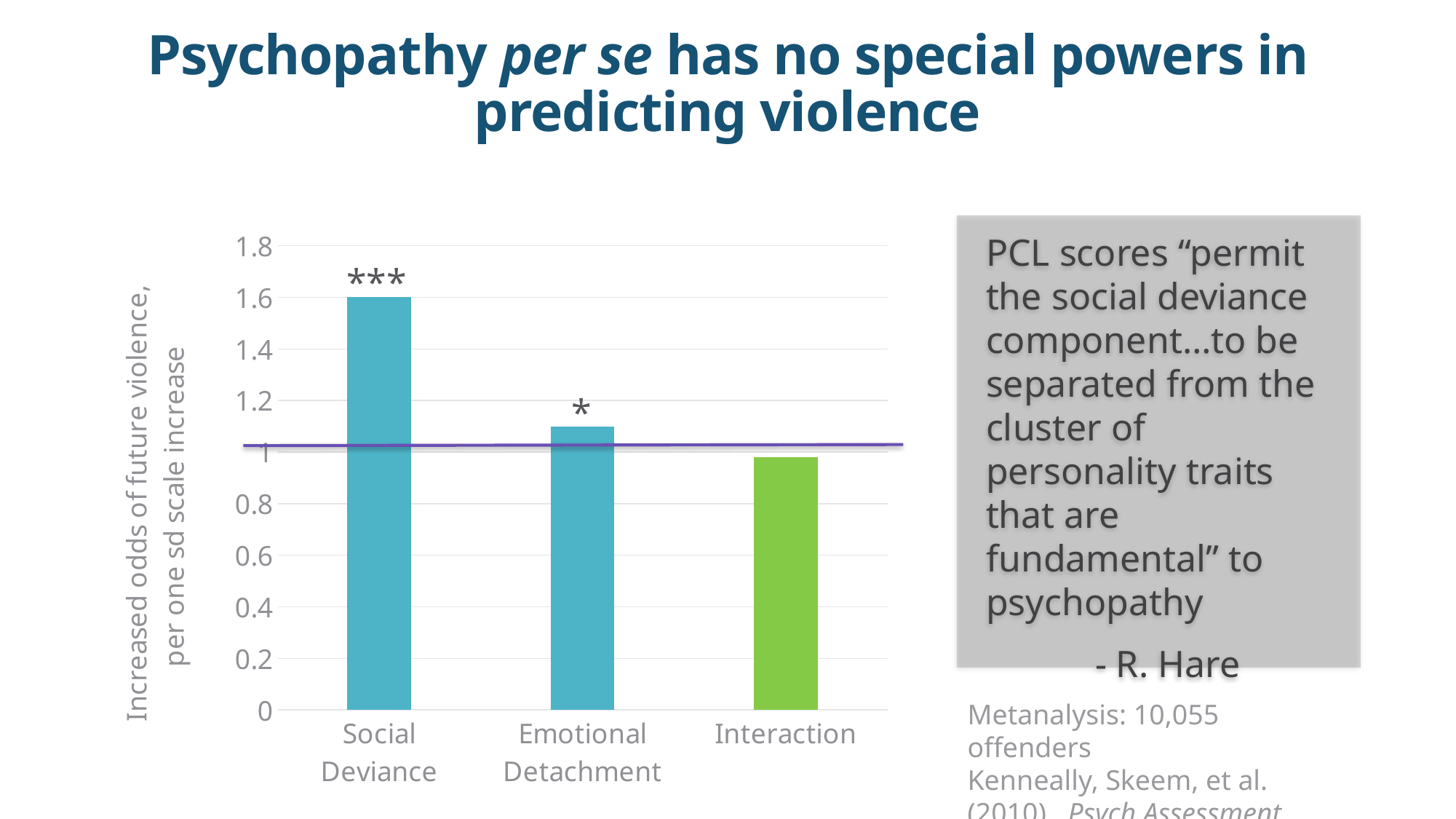
Is the value for Emotional Detachment greater or less than 1.2? less Which category has the lowest bar? Interaction What colour is the Interaction bar? green Which category has the highest bar? Social Deviance What is the value for Social Deviance? 1.6 Which is larger, the value for Social Deviance or the value for Emotional Detachment? Social Deviance Is the value for Interaction greater or less than 1.2? less How many categories are plotted on the bar chart? 3 What kind of chart is shown on the slide? bar chart Do the bar values rise or fall from left to right across the categories? fall What is the label on the vertical axis of the chart? Increased odds of future violence, per one sd scale increase Is the value for Social Deviance greater or less than 1.4? greater